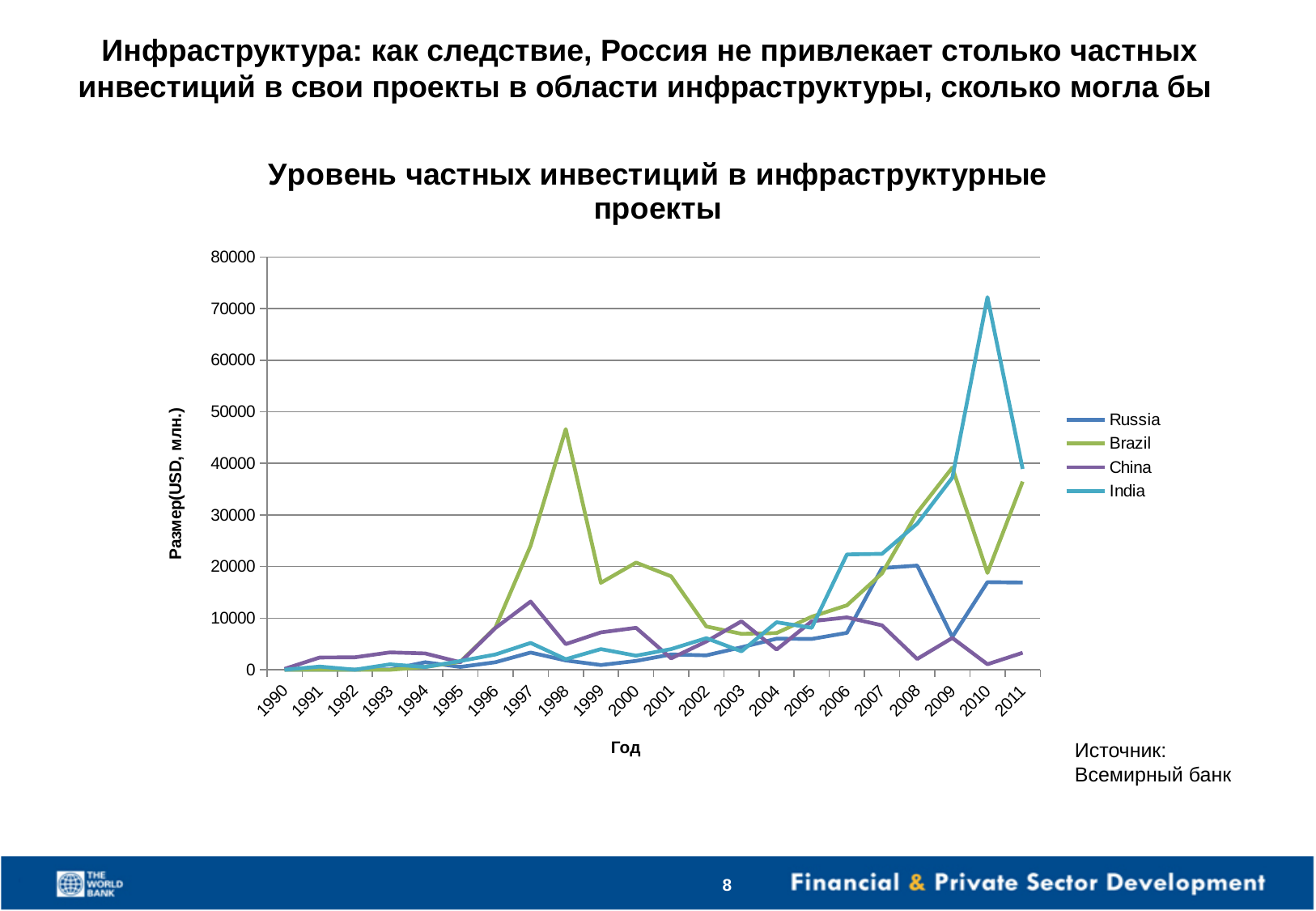
Is the value for Russia in 2011 greater or less than 20000? less Which series reaches the highest value anywhere on the chart? India In 2010, which is larger: the value for India or the value for Brazil? India Is the value for India in 2010 greater or less than 60000? greater How many years are plotted along the x axis? 22 In 1998, which is larger: the value for Brazil or the value for Russia? Brazil In which year does the India line reach its peak? 2010 Is the value for Brazil in 1998 greater or less than 40000? greater How many series does the legend list? 4 What is the label of the y axis? Размер(USD, млн.) What kind of chart is shown on the slide? line chart